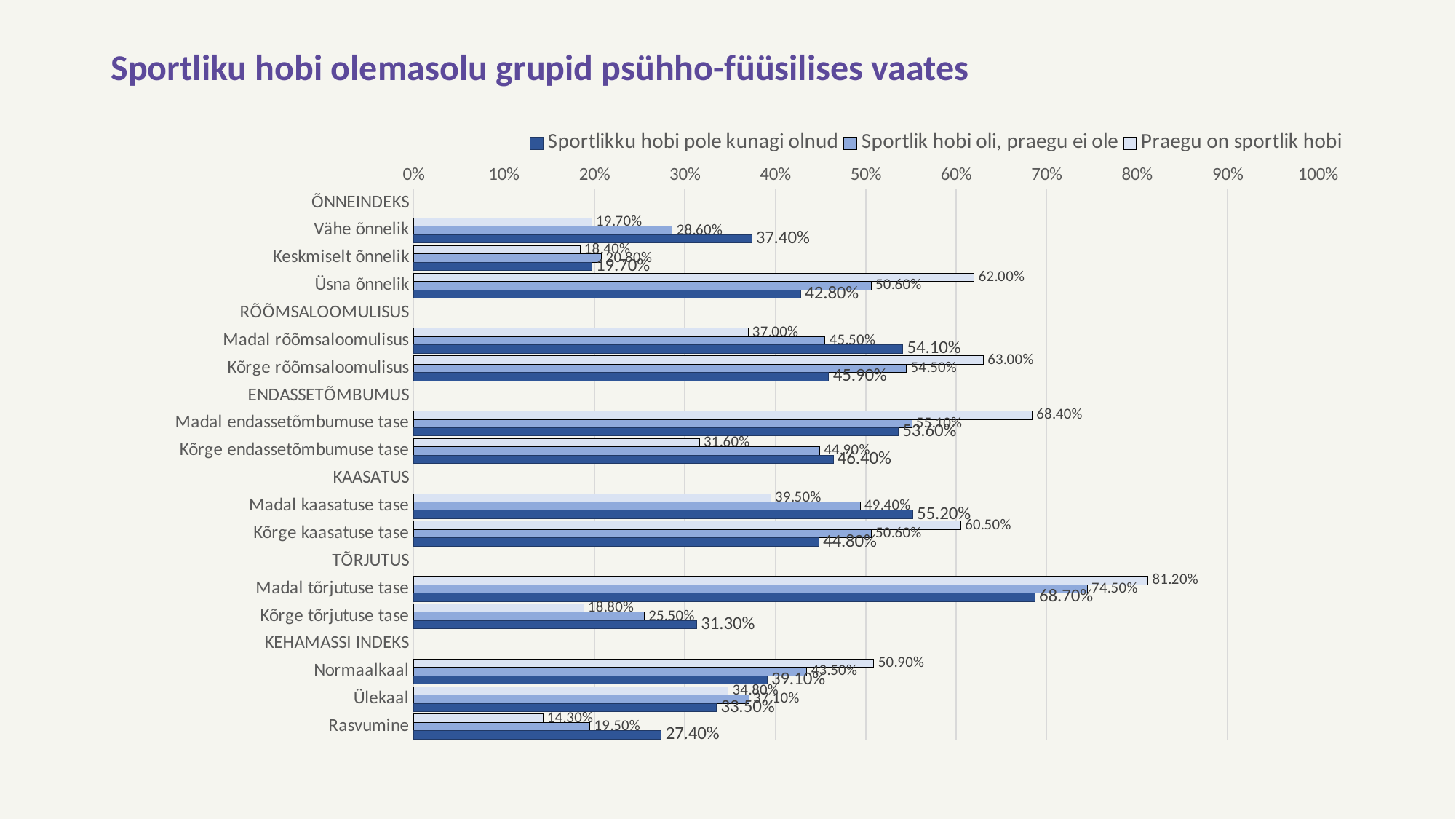
Which category has the lowest value for the 'Sportlikku hobi pole kunagi olnud' series? Keskmiselt õnnelik What is the difference between the 'Praegu on sportlik hobi' and 'Sportlikku hobi pole kunagi olnud' values for 'Üsna õnnelik'? 19.20% What is the title of the chart? Sportliku hobi olemasolu grupid psühho-füüsilises vaates What type of chart is shown on the slide? bar chart What is the value for 'Sportlik hobi oli, praegu ei ole' in the 'Kõrge tõrjutuse tase' category? 25.50% For 'Kõrge rõõmsaloomulisus', which is larger: the 'Praegu on sportlik hobi' value or the 'Sportlikku hobi pole kunagi olnud' value? Praegu on sportlik hobi What is the value for 'Sportlikku hobi pole kunagi olnud' in the 'Vähe õnnelik' category? 37.40% Is the 'Sportlikku hobi pole kunagi olnud' value for 'Madal tõrjutuse tase' greater or less than 60%? greater Which category has the highest value for the 'Praegu on sportlik hobi' series? Madal tõrjutuse tase What is the value for 'Praegu on sportlik hobi' in the 'Madal tõrjutuse tase' category? 81.20% What is the value for 'Praegu on sportlik hobi' in the 'Rasvumine' category? 14.30% How many series does the legend list? 3